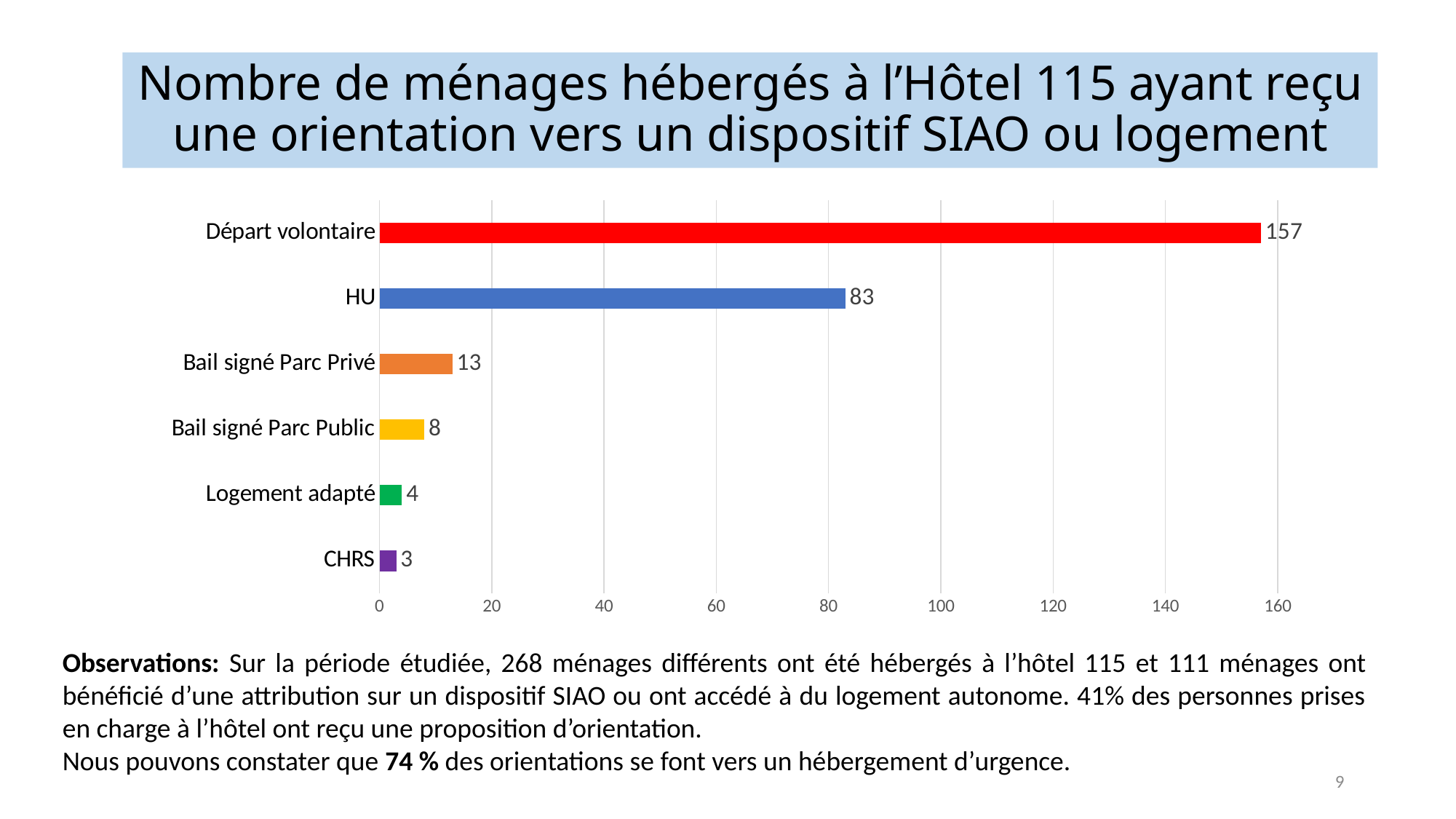
What is the value for Départ volontaire? 157 What is the value for Bail signé Parc Public? 8 Is the value for HU greater or less than 100? less What is the value for HU? 83 What is the value for Bail signé Parc Privé? 13 What kind of chart is shown on the slide? bar chart Which category has the highest value? Départ volontaire Which category has the lowest value? CHRS How many categories are shown in the chart? 6 What is the value for CHRS? 3 Which is larger, the value for Bail signé Parc Privé or the value for Bail signé Parc Public? Bail signé Parc Privé What is the difference between the values for Départ volontaire and HU? 74